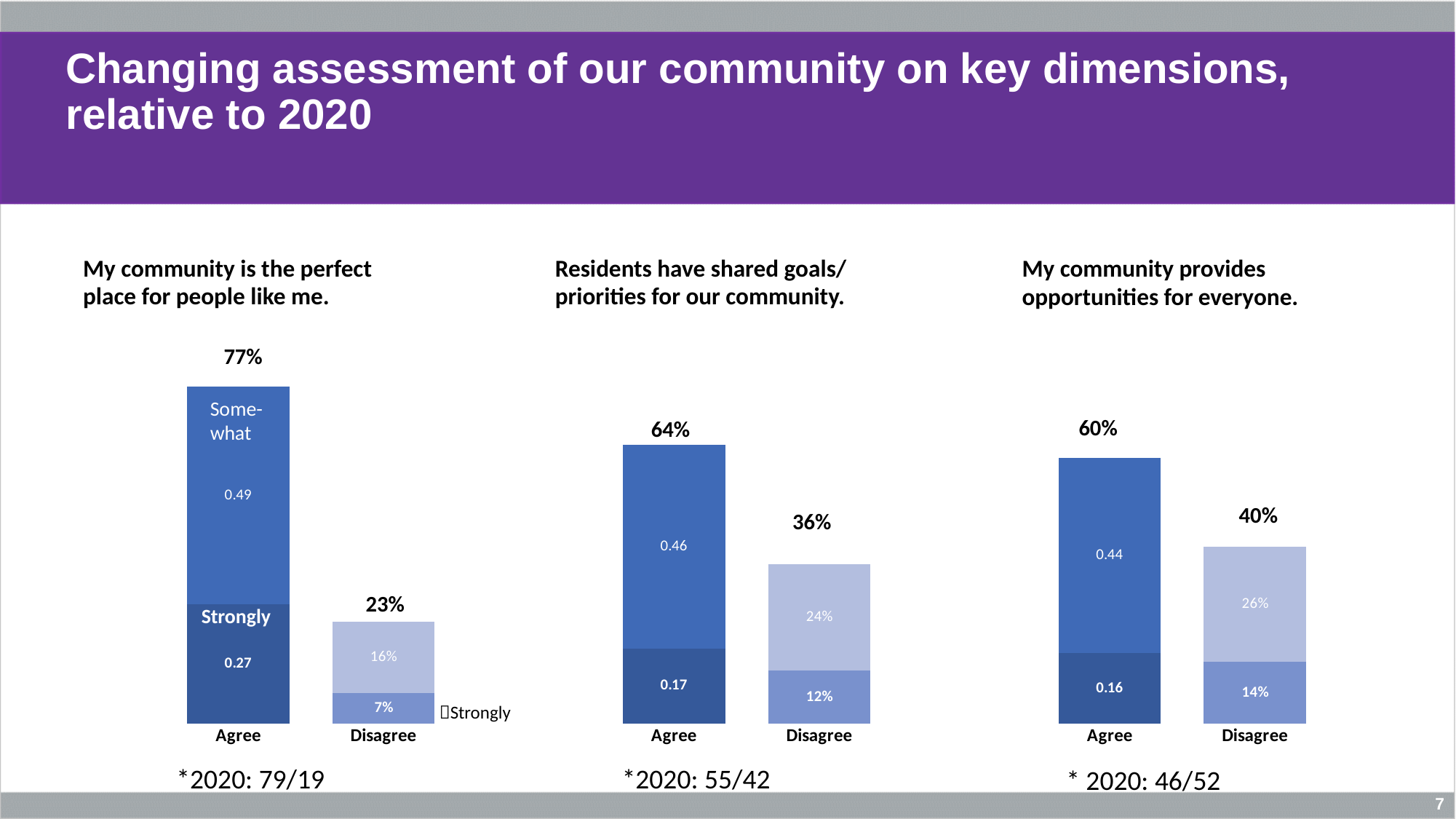
In the chart titled "Residents have shared goals/priorities for our community.", what value is printed in the bottom segment of the Disagree bar? 12% In the chart titled "My community provides opportunities for everyone.", what is the difference between the Agree total and the Disagree total? 20% In the chart titled "Residents have shared goals/priorities for our community.", what is the difference between the Agree total and the Disagree total? 28% In the chart titled "Residents have shared goals/priorities for our community.", what is the total labelled above the Disagree bar? 36% In the chart titled "My community provides opportunities for everyone.", what value is printed in the top segment of the Disagree bar? 26% How many bars are shown in the chart titled "My community provides opportunities for everyone."? 2 What 2020 comparison figures are printed below the chart titled "My community provides opportunities for everyone."? 46/52 In the chart titled "My community is the perfect place for people like me.", what value is printed in the Strongly segment of the Agree bar? 0.27 In the chart titled "My community is the perfect place for people like me.", which bar is taller, Agree or Disagree? Agree In the chart titled "My community is the perfect place for people like me.", what value is printed in the bottom segment of the Disagree bar? 7% In the chart titled "My community is the perfect place for people like me.", what is the total value labelled above the Agree bar? 77% What kind of chart is used in the chart titled "Residents have shared goals/priorities for our community."? Stacked bar chart